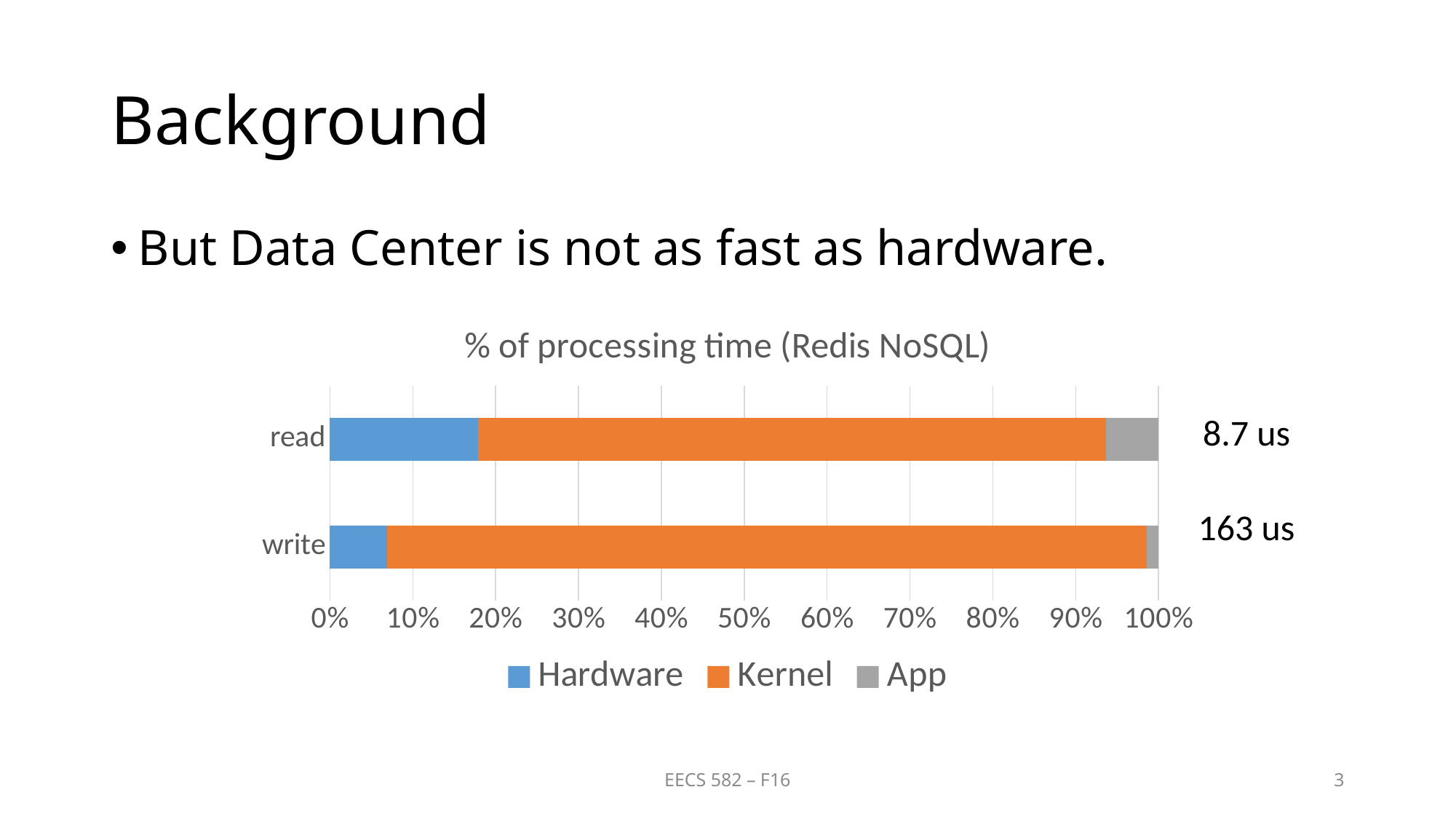
Is the Hardware share for read greater or less than 10%? greater Is the Hardware share for write greater or less than 10%? less Which category has the larger Kernel share, read or write? write Is the App share for read greater or less than 10%? less What kind of chart is shown on the slide? bar chart How many series does the legend list? 3 Which series is shown in orange in the legend? Kernel What is the total of the stacked bar for read? 100% Which category has the larger Hardware share, read or write? read What is the title of the chart? % of processing time (Redis NoSQL) How many categories are plotted on the chart? 2